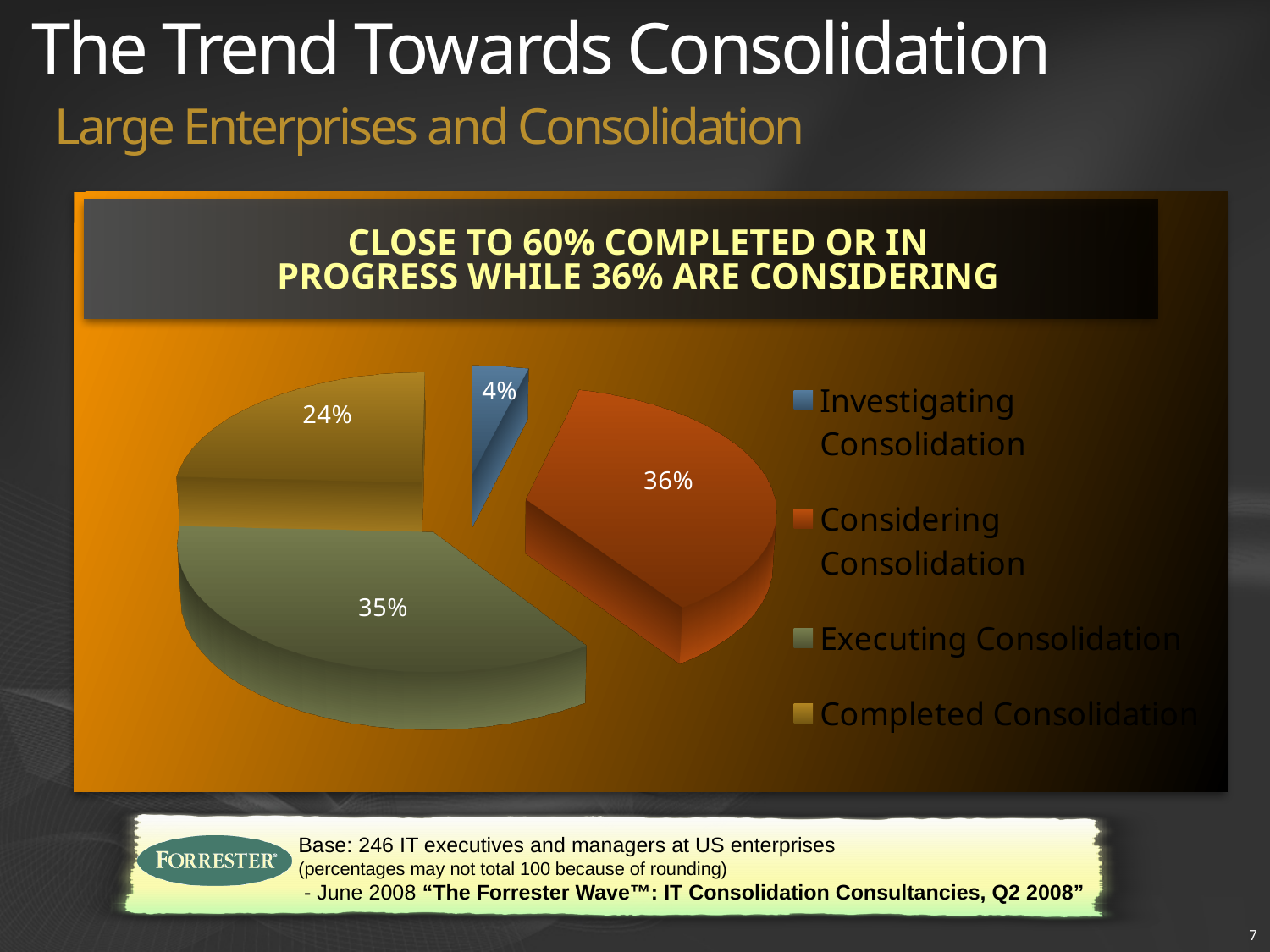
How many slices does the pie chart have? 4 What percentage of the pie is Completed Consolidation? 24% What kind of chart is shown on the slide? pie chart Which is larger, the Executing Consolidation slice or the Completed Consolidation slice? Executing Consolidation Which category has the smallest slice of the pie? Investigating Consolidation What colour is the Investigating Consolidation slice? blue What percentage of the pie is Executing Consolidation? 35% What share of the pie does Investigating Consolidation take? 4% How many entries does the legend list? 4 What is the difference in percentage points between Considering Consolidation and Investigating Consolidation? 32 Which category has the largest slice of the pie? Considering Consolidation What percentage of the pie is Considering Consolidation? 36%